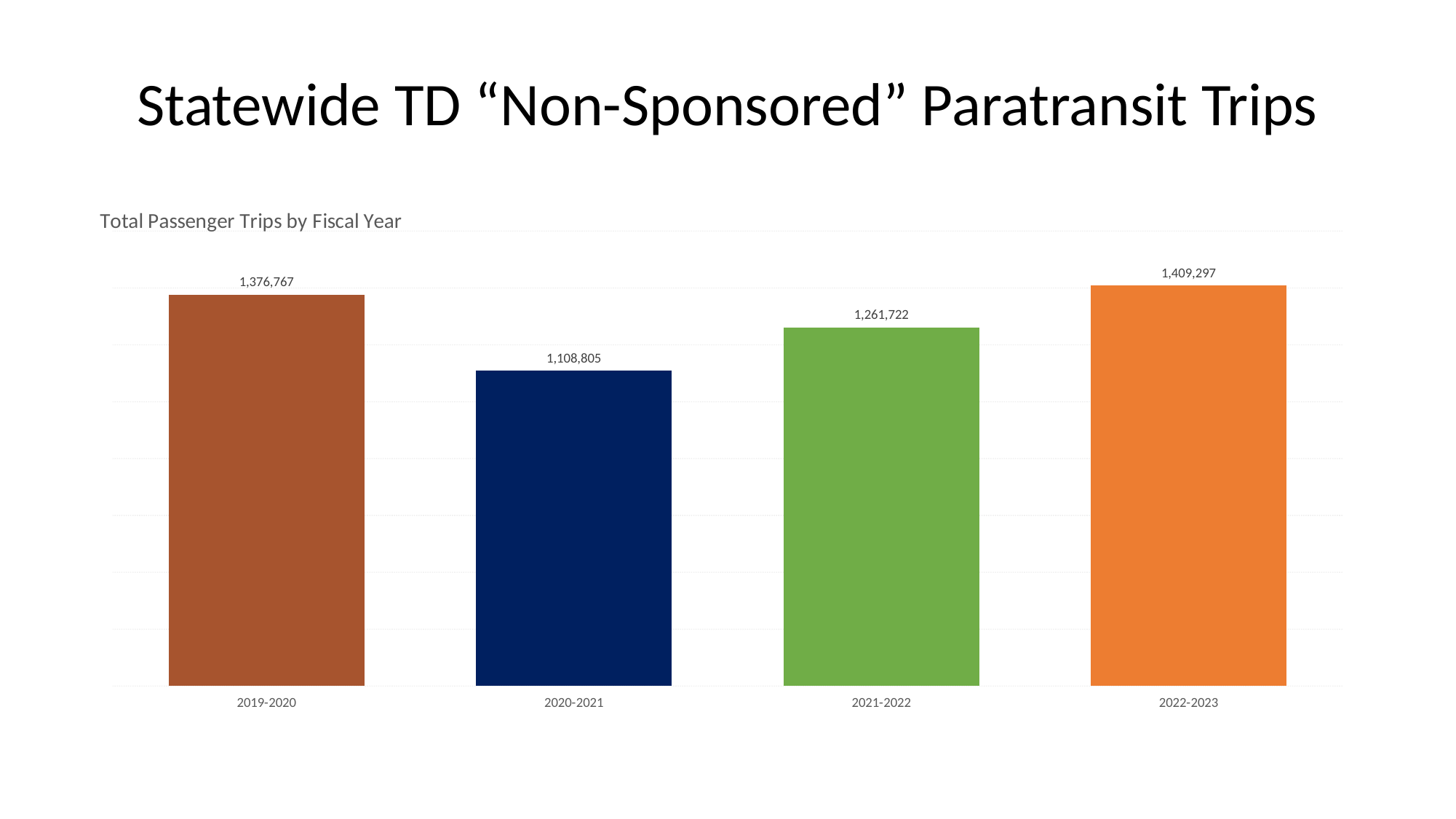
What is the difference between the values for 2019-2020 and 2020-2021? 267,962 What kind of chart is shown on the slide? Bar chart How many fiscal years are shown in the chart? 4 From 2020-2021 to 2022-2023, do the values rise or fall? Rise Which is larger, the value for 2021-2022 or the value for 2020-2021? 2021-2022 What is the value for 2022-2023? 1,409,297 Which fiscal year has the highest number of passenger trips? 2022-2023 What is the difference between the values for 2022-2023 and 2019-2020? 32,530 What is the value for 2021-2022? 1,261,722 What is the value for 2019-2020? 1,376,767 What is the value for 2020-2021? 1,108,805 Which fiscal year has the lowest number of passenger trips? 2020-2021